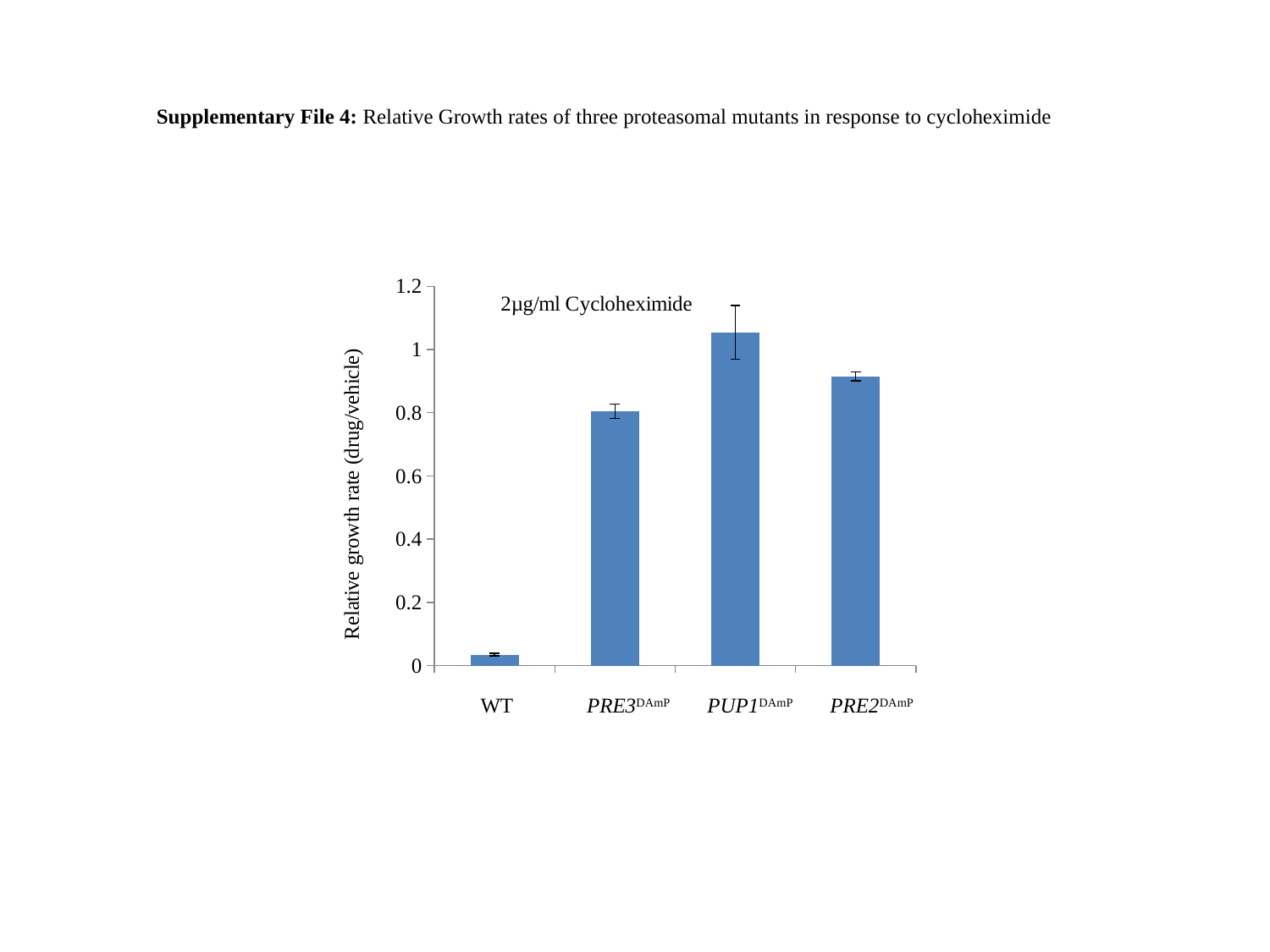
What drug concentration is stated in the text inside the chart area? 2µg/ml Cycloheximide Which category has the highest relative growth rate? PUP1DAmP What kind of chart is shown on the slide? Bar chart How many categories (bars) are plotted in the chart? 4 Is the value for PUP1DAmP greater or less than 1? greater Is the value for PRE2DAmP greater or less than 1? less Is the value for WT greater or less than 0.2? less Which category has the lowest relative growth rate? WT Which has a larger relative growth rate, PRE2DAmP or PRE3DAmP? PRE2DAmP Which has a larger relative growth rate, PUP1DAmP or PRE3DAmP? PUP1DAmP What is the label on the y axis of the chart? Relative growth rate (drug/vehicle)